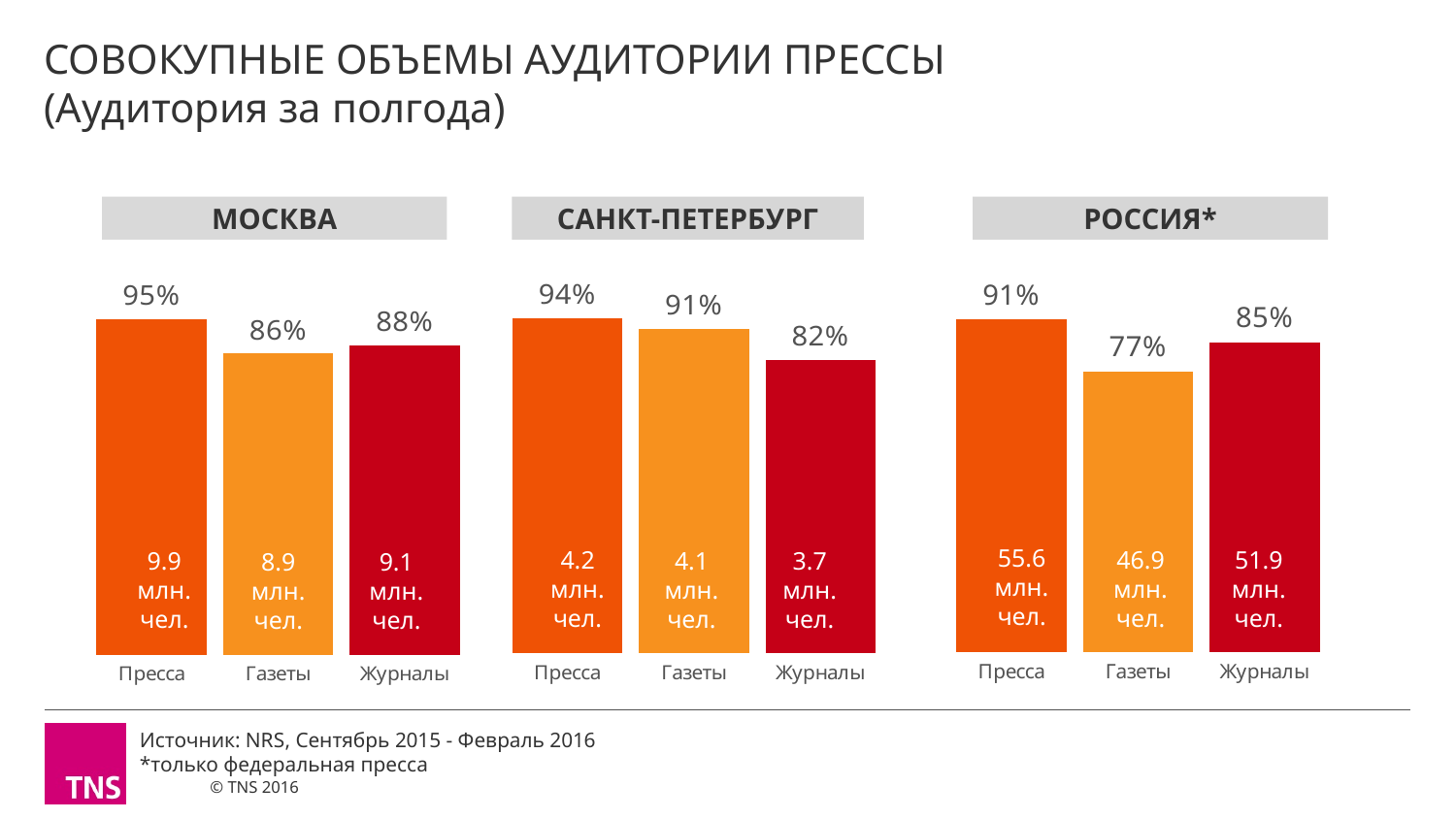
In the САНКТ-ПЕТЕРБУРГ chart, what is the difference in percentage points between Пресса and Журналы? 12 What is the title of the slide? СОВОКУПНЫЕ ОБЪЕМЫ АУДИТОРИИ ПРЕССЫ (Аудитория за полгода) In the МОСКВА chart, what percentage is shown for Пресса? 95% How many bars are in the САНКТ-ПЕТЕРБУРГ chart? 3 In the РОССИЯ* chart, how many million people are shown for Пресса? 55.6 млн. чел. In the РОССИЯ* chart, which category has the highest percentage? Пресса In the МОСКВА chart, which is larger, the percentage for Газеты or for Журналы? Журналы What type of chart is used for МОСКВА? Bar chart In the РОССИЯ* chart, what percentage is shown for Газеты? 77% In the САНКТ-ПЕТЕРБУРГ chart, how many million people are shown for Журналы? 3.7 млн. чел. In the МОСКВА chart, what is the difference in million people between Пресса and Газеты? 1.0 млн. чел. In the МОСКВА chart, which category has the lowest percentage? Газеты